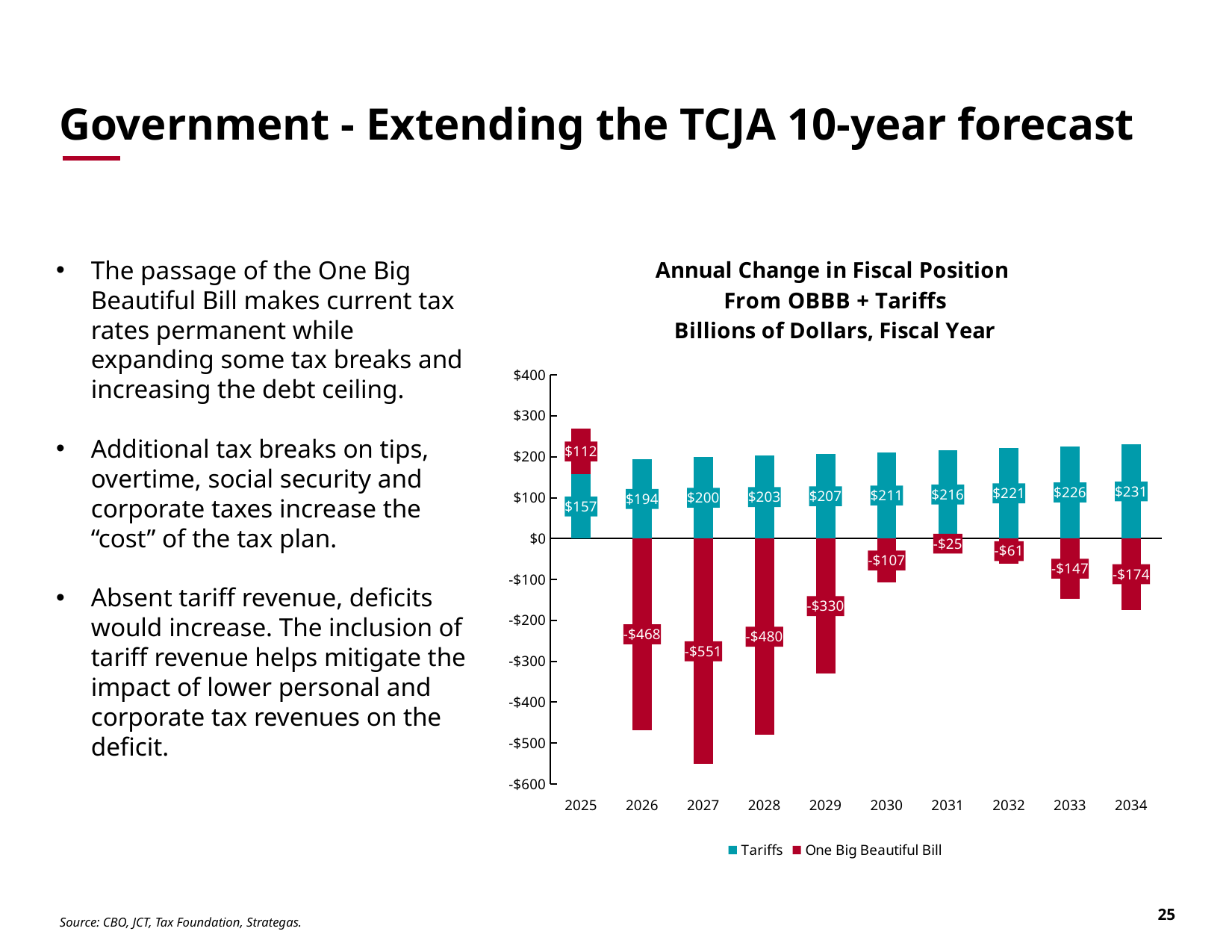
Which year has the highest Tariffs value? 2034 What is the One Big Beautiful Bill value for 2025? $112 Which is larger in magnitude, the One Big Beautiful Bill value for 2026 or for 2029? 2026 How many years are shown on the x axis? 10 What is the Tariffs value for 2030? $211 Do the Tariffs values rise or fall from 2025 to 2034? Rise Which year has the lowest One Big Beautiful Bill value? 2027 What is the net total of the 2031 bar (Tariffs plus One Big Beautiful Bill)? $191 What kind of chart is shown? Stacked bar chart How many series does the legend list? 2 What is the One Big Beautiful Bill value for 2027? -$551 What is the difference between the Tariffs values for 2034 and 2025? $74